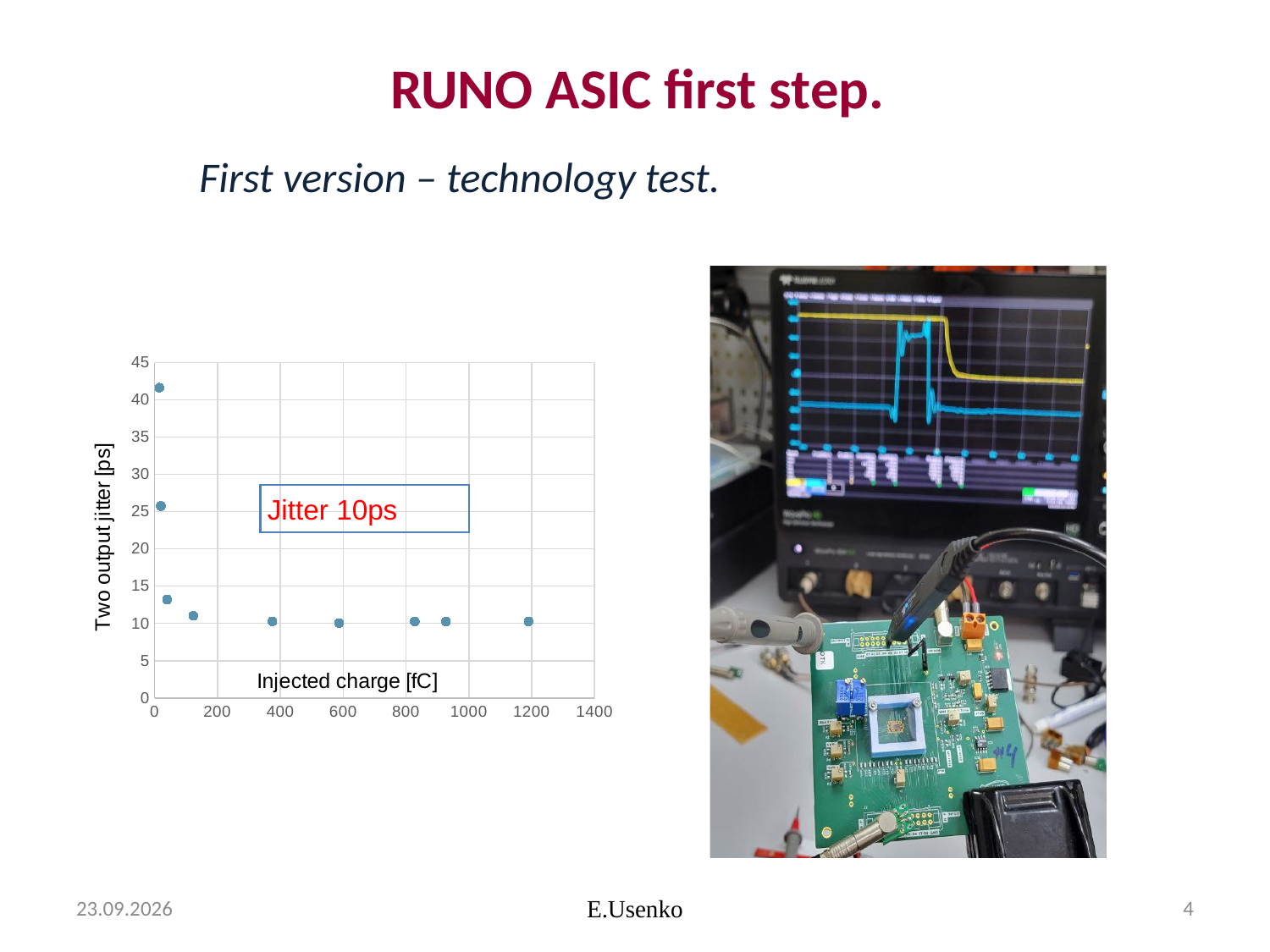
What kind of chart is shown on the slide? scatter chart What is the maximum value shown on the vertical axis of the chart? 45 Is the jitter value for the point near 1200 fC greater or less than 15? less Is the jitter value for the second-highest point greater or less than 20? greater Is the jitter value for the point near 600 fC greater or less than 20? less Which is larger: the jitter for the point near 120 fC or the jitter for the point near 830 fC? the point near 120 fC What is the maximum value shown on the horizontal axis of the chart? 1400 What is the label of the horizontal axis of the chart? Injected charge [fC] Do the jitter values rise or fall as the injected charge increases along the x axis? fall How many data points are plotted in the chart? 9